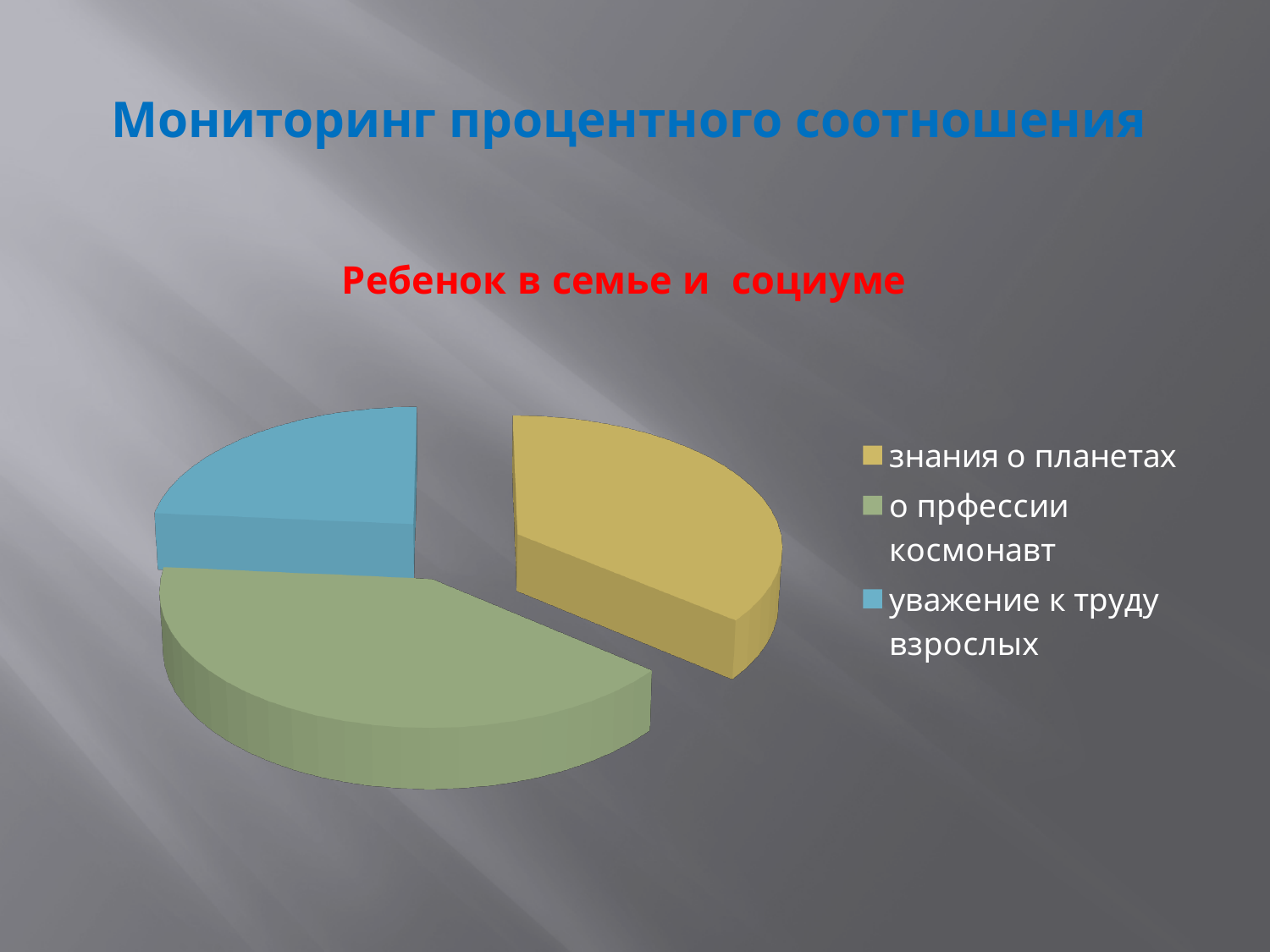
Which category has the largest slice in the pie chart? о прфессии космонавт How many slices does the pie chart have? 3 Which slice is larger: "о прфессии космонавт" or "уважение к труду взрослых"? о прфессии космонавт How many entries does the legend of the pie chart list? 3 Which slice is larger: "о прфессии космонавт" or "знания о планетах"? о прфессии космонавт What is the title of the pie chart? Ребенок в семье и социуме What colour is the slice for "уважение к труду взрослых"? blue What kind of chart is shown on the slide? pie chart